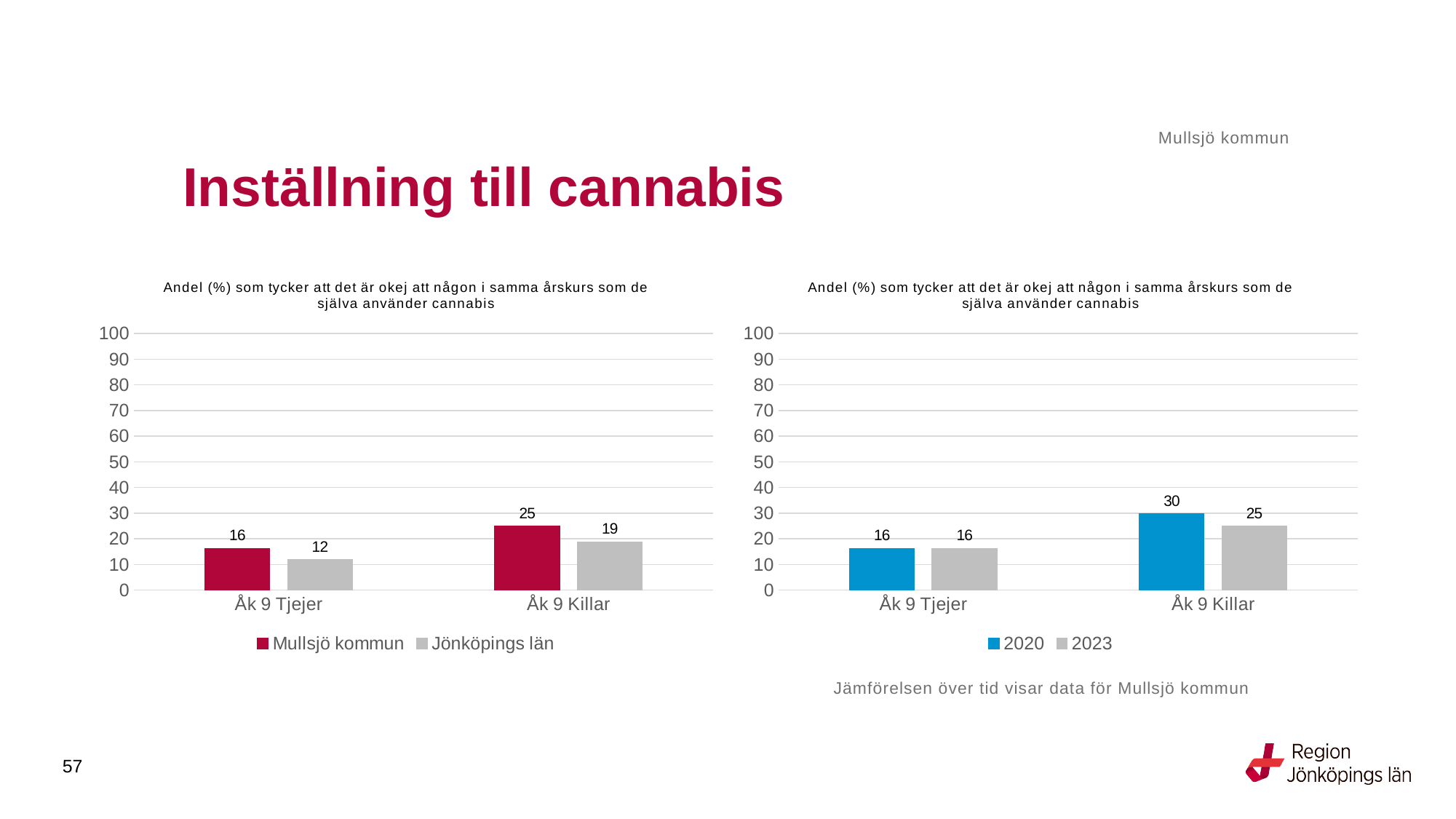
In the right chart, what is the value for 2023 for Åk 9 Tjejer? 16 In the left chart, what is the value for Jönköpings län for Åk 9 Killar? 19 In the right chart, what is the difference between 2020 and 2023 for Åk 9 Killar? 5 In the left chart, how many categories are shown on the x axis? 2 In the left chart, what is the difference between Mullsjö kommun and Jönköpings län for Åk 9 Killar? 6 In the left chart, what is the value for Mullsjö kommun for Åk 9 Tjejer? 16 In the right chart, which bar is the highest? 2020 for Åk 9 Killar How many series does the legend of the right chart list? 2 In the right chart, what is the value for 2020 for Åk 9 Killar? 30 In the left chart, which is larger for Åk 9 Tjejer: Mullsjö kommun or Jönköpings län? Mullsjö kommun In the left chart, which bar is the lowest? Jönköpings län for Åk 9 Tjejer What kind of chart is the left chart? Bar chart